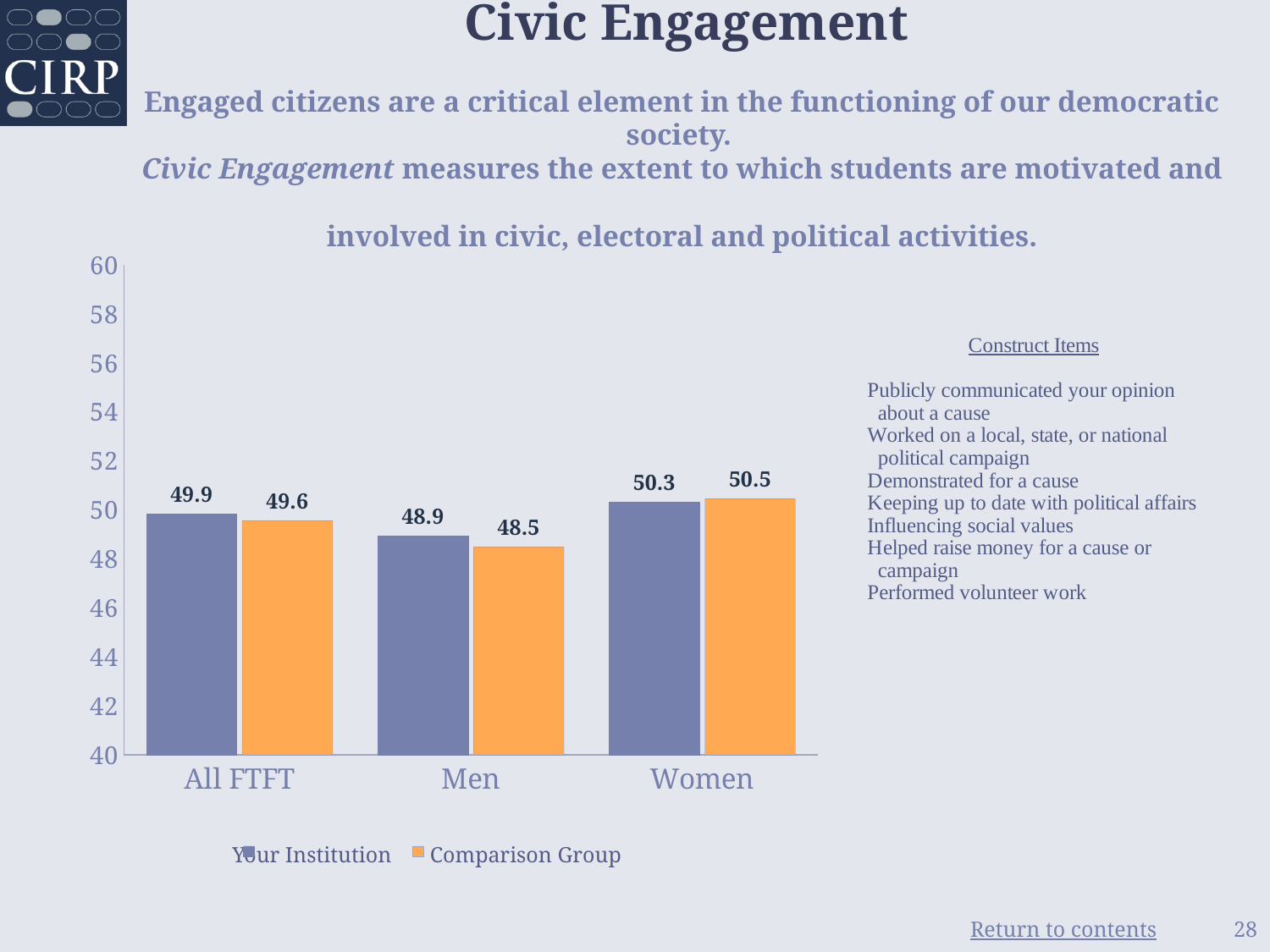
Which category has the highest Your Institution value? Women What is the difference between the Your Institution and Comparison Group values for Men? 0.4 Which category has the lowest Comparison Group value? Men What is the Comparison Group value for Women? 50.5 What kind of chart is shown on the slide? Bar chart What colour are the Comparison Group bars? Orange What is the Your Institution value for Men? 48.9 What is the Your Institution value for All FTFT? 49.9 For Women, which is larger: Your Institution or Comparison Group? Comparison Group How many categories are shown on the x axis? 3 How many series does the legend list? 2 What is the Comparison Group value for Men? 48.5